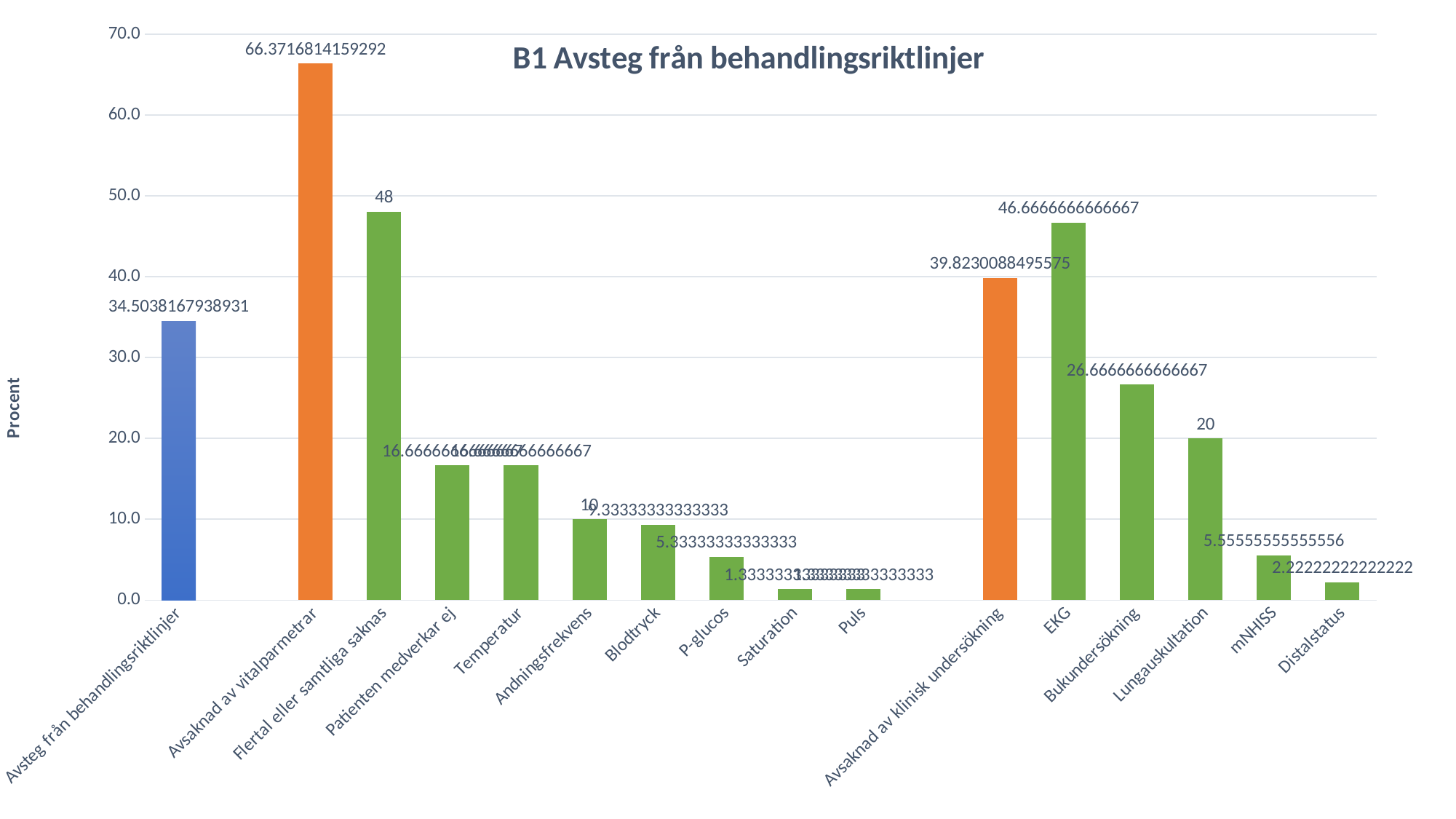
What kind of chart is shown on the slide? bar chart What is the label of the y axis? Procent What is the value for Avsaknad av vitalparmetrar? 66.3716814159292 Which is larger, the value for Flertal eller samtliga saknas or the value for EKG? Flertal eller samtliga saknas What is the value for EKG? 46.6666666666667 How many categories are shown on the x axis? 16 What is the difference between the values for Flertal eller samtliga saknas and Lungauskultation? 28 What is the value for Distalstatus? 2.22222222222222 What is the value for Avsaknad av klinisk undersökning? 39.8230088495575 Which category has the highest value? Avsaknad av vitalparmetrar What is the value for Lungauskultation? 20 Is the value for Patienten medverkar ej greater or less than 20? less